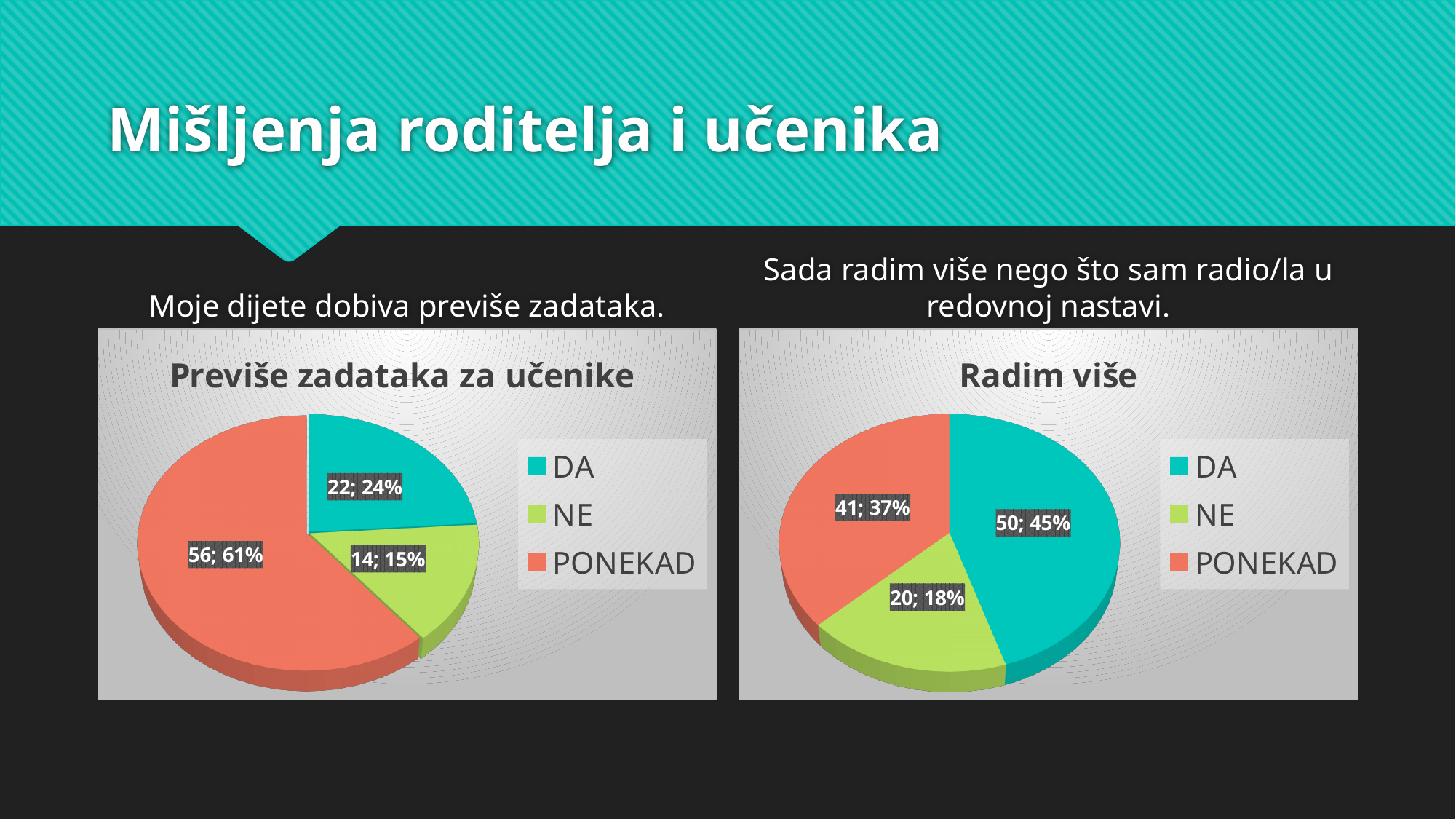
In the 'Radim više' chart, which category has the largest slice? DA In the 'Radim više' chart, which colour represents NE in the legend? Green In the 'Radim više' chart, which is larger, the count for NE or the count for PONEKAD? PONEKAD In the 'Previše zadataka za učenike' chart, what is the count for PONEKAD? 56 How many categories does the 'Previše zadataka za učenike' chart have? 3 In the 'Radim više' chart, what percentage share does PONEKAD have? 37% In the 'Previše zadataka za učenike' chart, what is the difference between the PONEKAD count and the DA count? 34 In the 'Radim više' chart, what is the total of all three counts? 111 In the 'Previše zadataka za učenike' chart, which category has the smallest slice? NE In the 'Previše zadataka za učenike' chart, what percentage share does DA have? 24% What type of chart is 'Radim više'? Pie chart In the 'Radim više' chart, what is the count for DA? 50